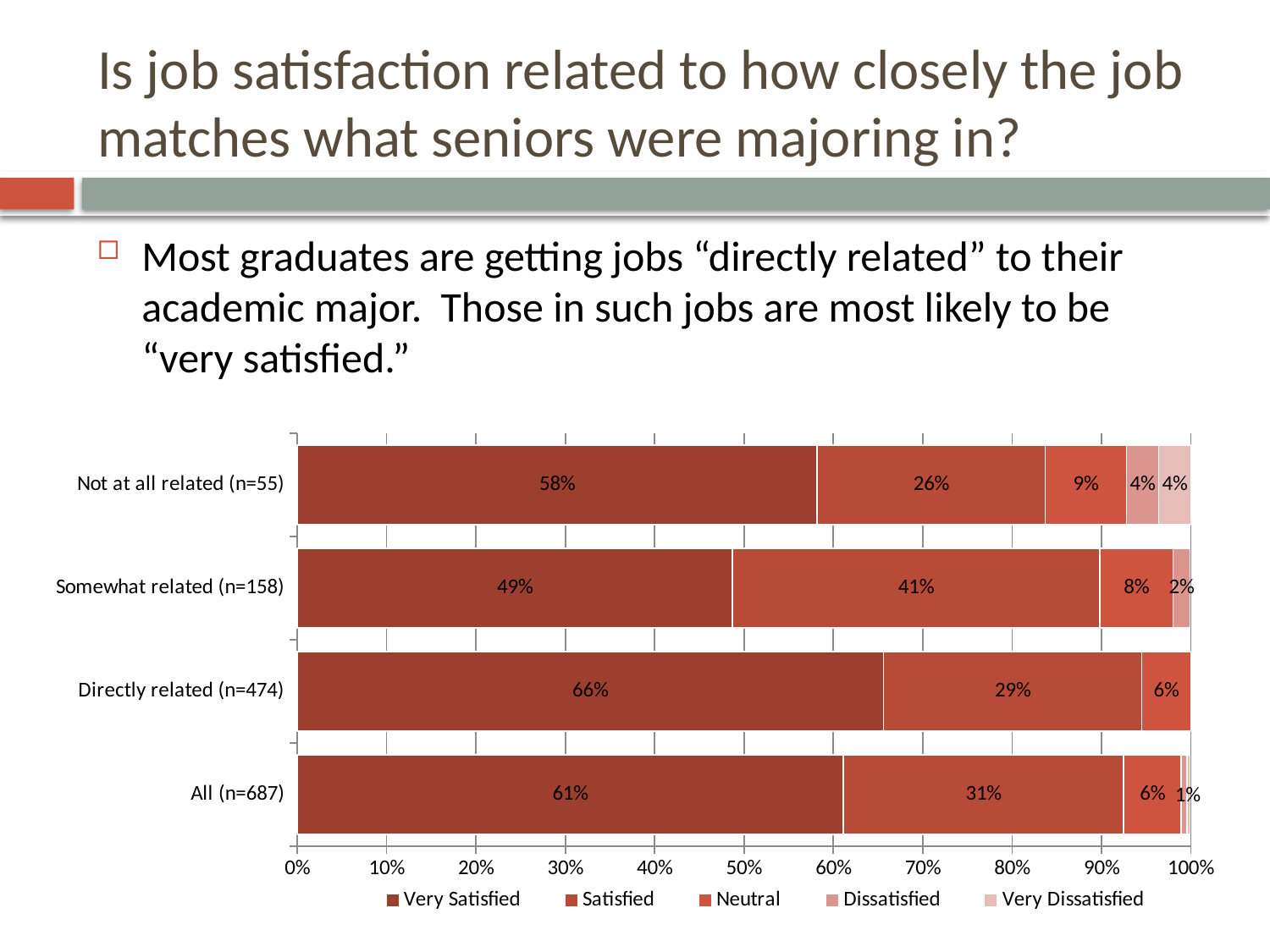
What is the difference between the Very Satisfied values for Directly related (n=474) and Somewhat related (n=158)? 17% Which legend entry is shown in the darkest colour? Very Satisfied Which category has the lowest Very Satisfied value? Somewhat related (n=158) How many categories (bars) are shown in the chart? 4 What is the Neutral value for Not at all related (n=55)? 9% What kind of chart is shown on the slide? Stacked bar chart How many series does the legend list? 5 What is the Satisfied value for Somewhat related (n=158)? 41% What is the Very Satisfied value for All (n=687)? 61% Which is larger: the Satisfied value for Somewhat related (n=158) or for Directly related (n=474)? Somewhat related (n=158) Which category has the highest Very Satisfied value? Directly related (n=474) What is the Very Satisfied value for Directly related (n=474)? 66%